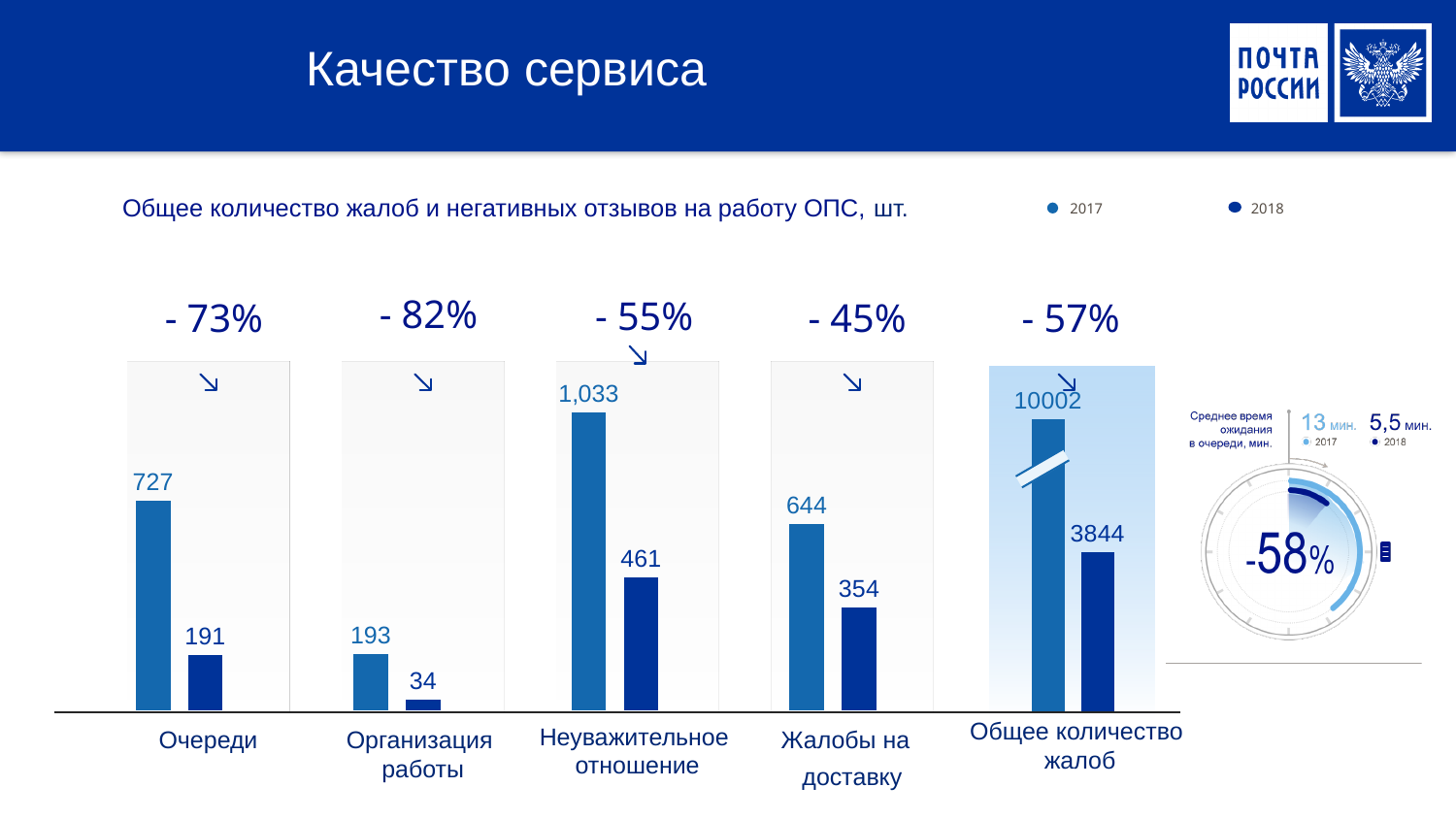
How many series does the legend of the bar chart list? 2 What is the 2018 value for Жалобы на доставку in the bar chart? 354 What is the 2017 value for Очереди in the bar chart? 727 What percentage change is shown above the Организация работы bars? - 82% Which category has the lowest 2018 value in the bar chart? Организация работы What is the 2017 value for Неуважительное отношение in the bar chart? 1,033 Which category has the highest 2017 value in the bar chart? Общее количество жалоб What is the difference between the 2017 and 2018 values for Очереди in the bar chart? 536 What is the 2018 value for Общее количество жалоб in the bar chart? 3844 What is the 2018 value for Организация работы in the bar chart? 34 How many categories are shown in the bar chart? 5 In the bar chart, is the 2018 value for Неуважительное отношение larger or smaller than the 2018 value for Жалобы на доставку? larger